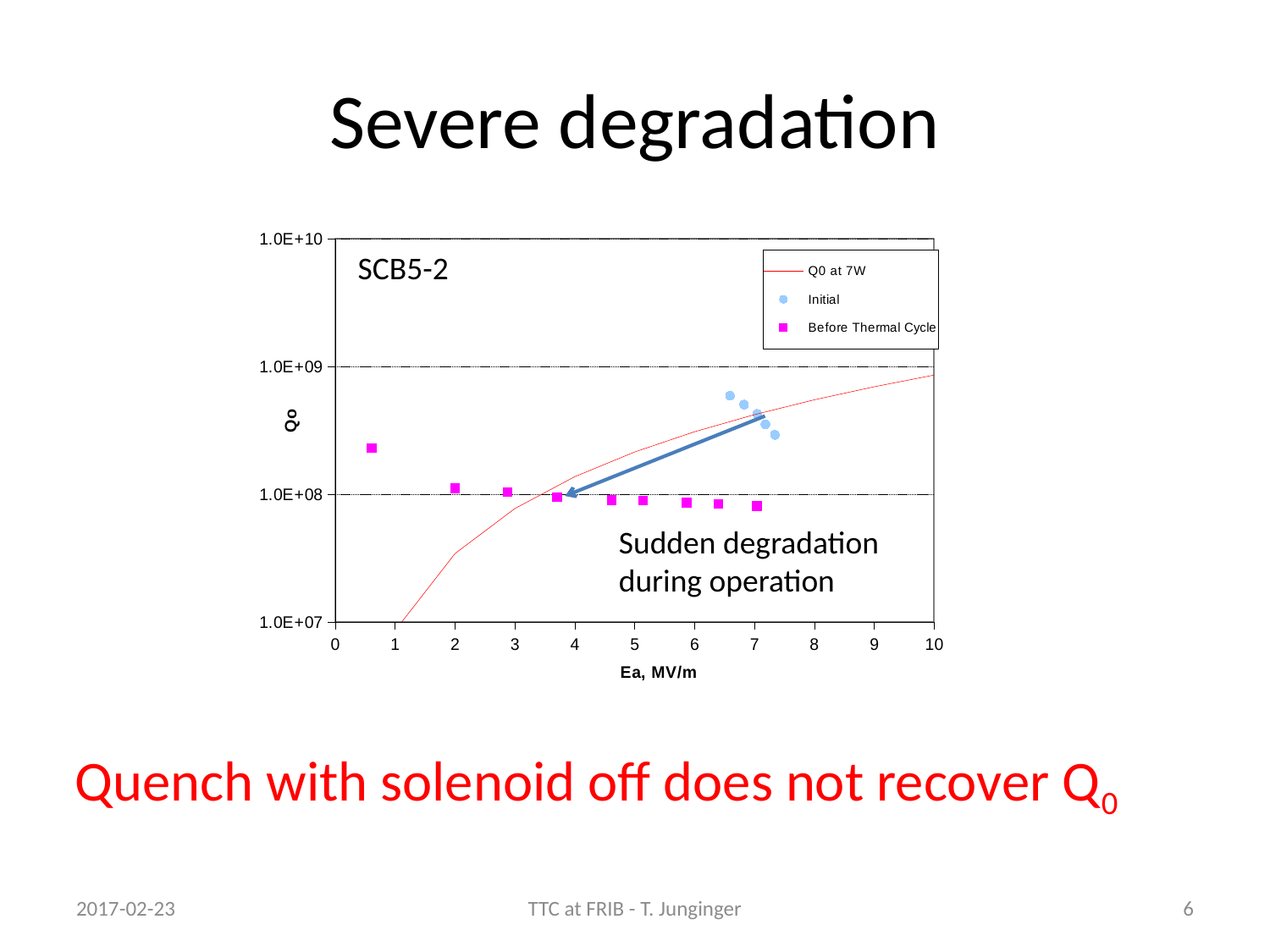
Is the 'Before Thermal Cycle' value at the lowest Ea (about 0.6 MV/m) greater or less than 1.0E+08? greater Are the 'Initial' data points greater or less than 1.0E+09 on the Qo axis? less How many 'Before Thermal Cycle' data points are plotted on the chart? 9 Is the 'Before Thermal Cycle' value at Ea of about 7 MV/m greater or less than 1.0E+08? less At Ea of about 7 MV/m, which series has the higher Qo: 'Initial' or 'Before Thermal Cycle'? Initial How many series does the chart legend list? 3 What kind of chart is shown on the slide? scatter chart Do the 'Before Thermal Cycle' values rise or fall as Ea increases? fall What are the three series listed in the chart legend? Q0 at 7W, Initial, Before Thermal Cycle Does the 'Q0 at 7W' line rise or fall as Ea increases? rise What is the label of the x axis of the chart? Ea, MV/m